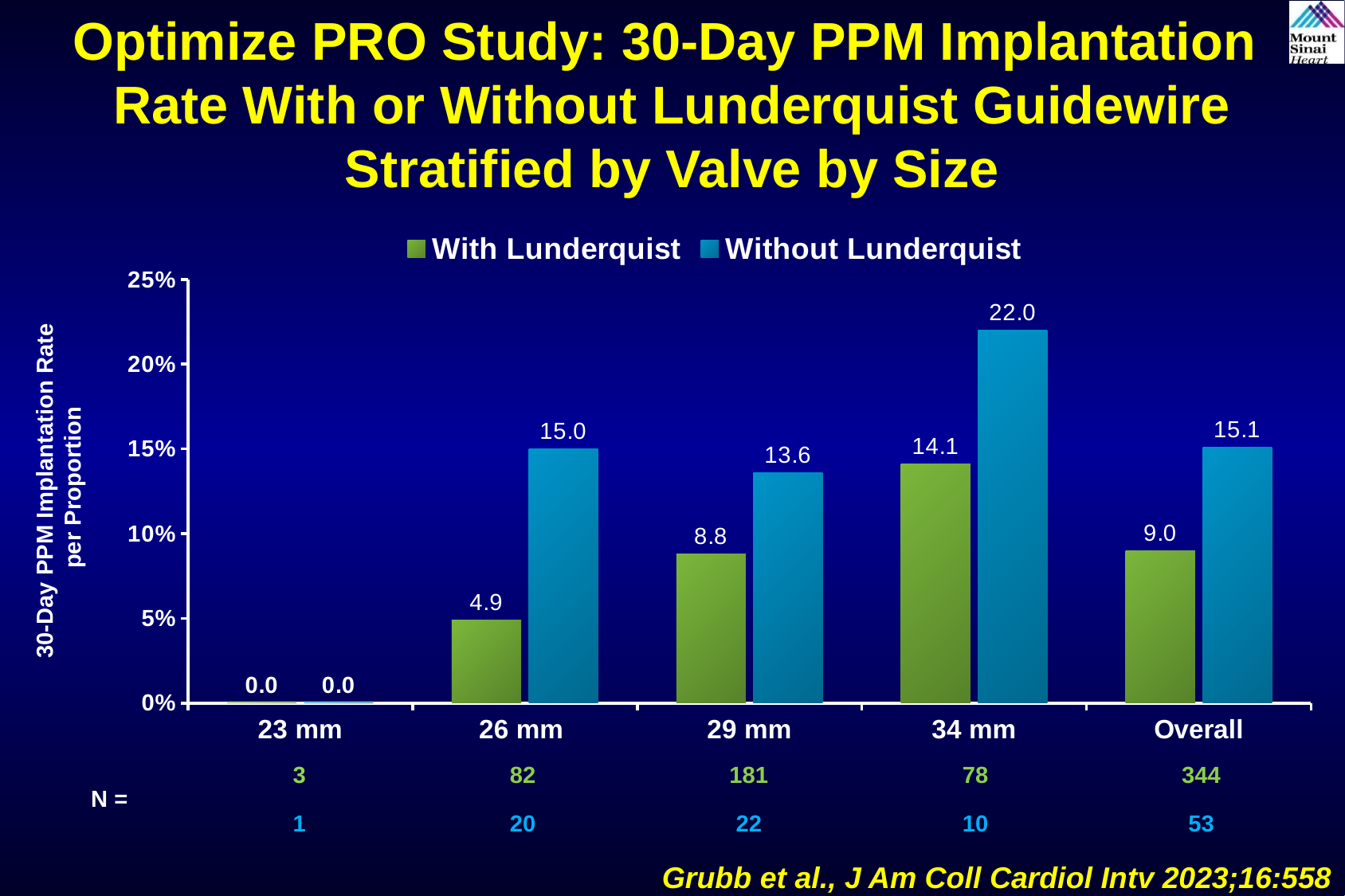
What is the 30-day PPM implantation rate for the With Lunderquist series at 26 mm? 4.9 How many series does the legend list? 2 What is the 30-day PPM implantation rate for the Without Lunderquist series at 34 mm? 22.0 How many valve size categories are shown on the x axis? 5 Which is larger at 26 mm: the With Lunderquist value or the Without Lunderquist value? Without Lunderquist What is the N for the Without Lunderquist group at 29 mm? 22 What is the Overall value for the With Lunderquist series? 9.0 Which valve size has the highest value for the Without Lunderquist series? 34 mm Is the Without Lunderquist value at 34 mm greater or less than 20%? greater Which valve size has the lowest value for the With Lunderquist series? 23 mm What kind of chart is shown on the slide? Bar chart What is the difference between the Without Lunderquist and With Lunderquist values at 29 mm? 4.8